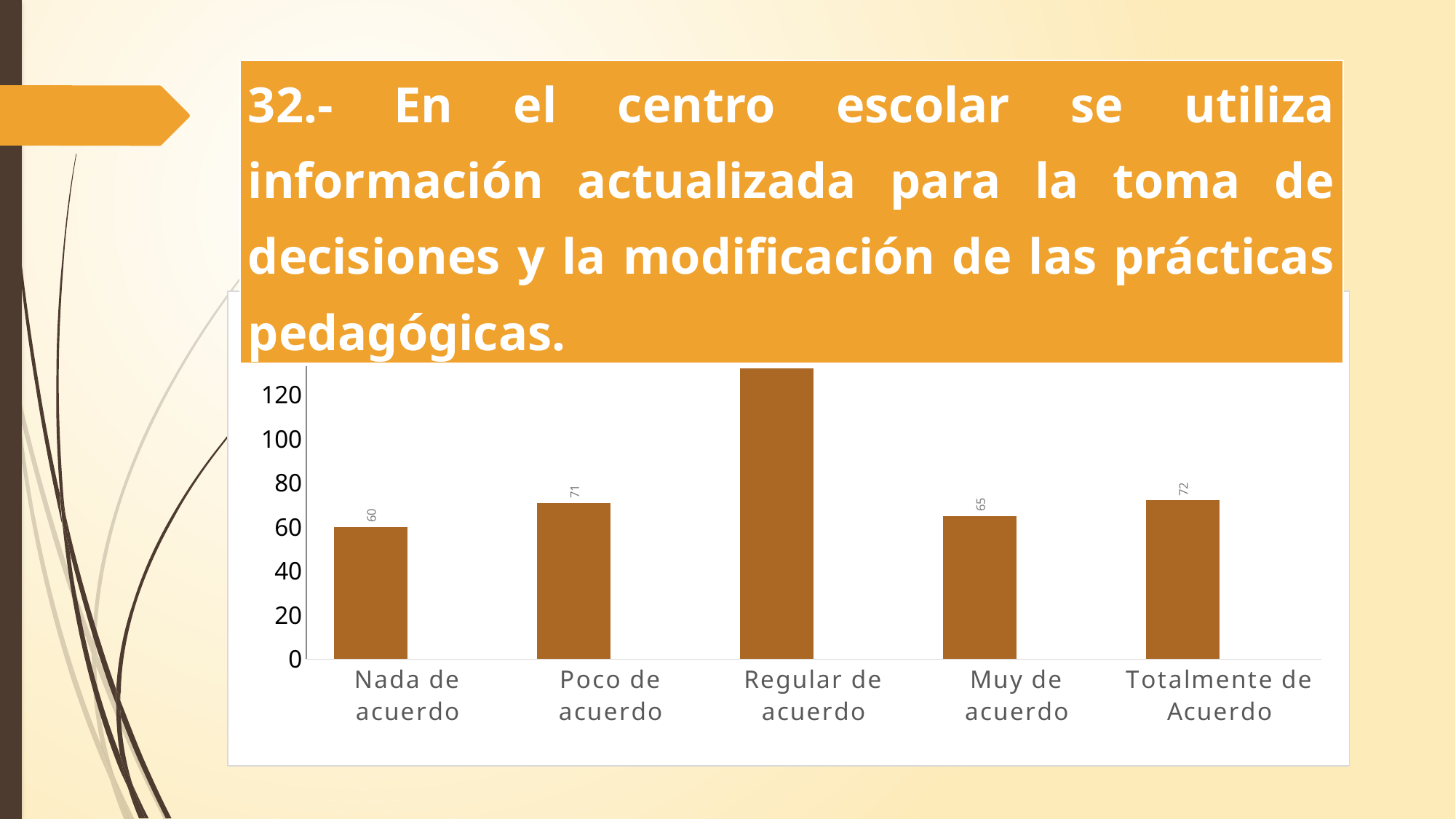
What is the difference between the values for Poco de acuerdo and Muy de acuerdo? 6 What is the value for Poco de acuerdo? 71 Which is larger, the value for Poco de acuerdo or the value for Muy de acuerdo? Poco de acuerdo What is the value for Muy de acuerdo? 65 Which category has the highest value? Regular de acuerdo What kind of chart is shown on the slide? Bar chart Is the value for Regular de acuerdo greater or less than 120? greater What is the value for Nada de acuerdo? 60 How many categories are shown on the x axis? 5 What is the difference between the values for Totalmente de Acuerdo and Nada de acuerdo? 12 What is the value for Totalmente de Acuerdo? 72 Which category has the lowest value? Nada de acuerdo